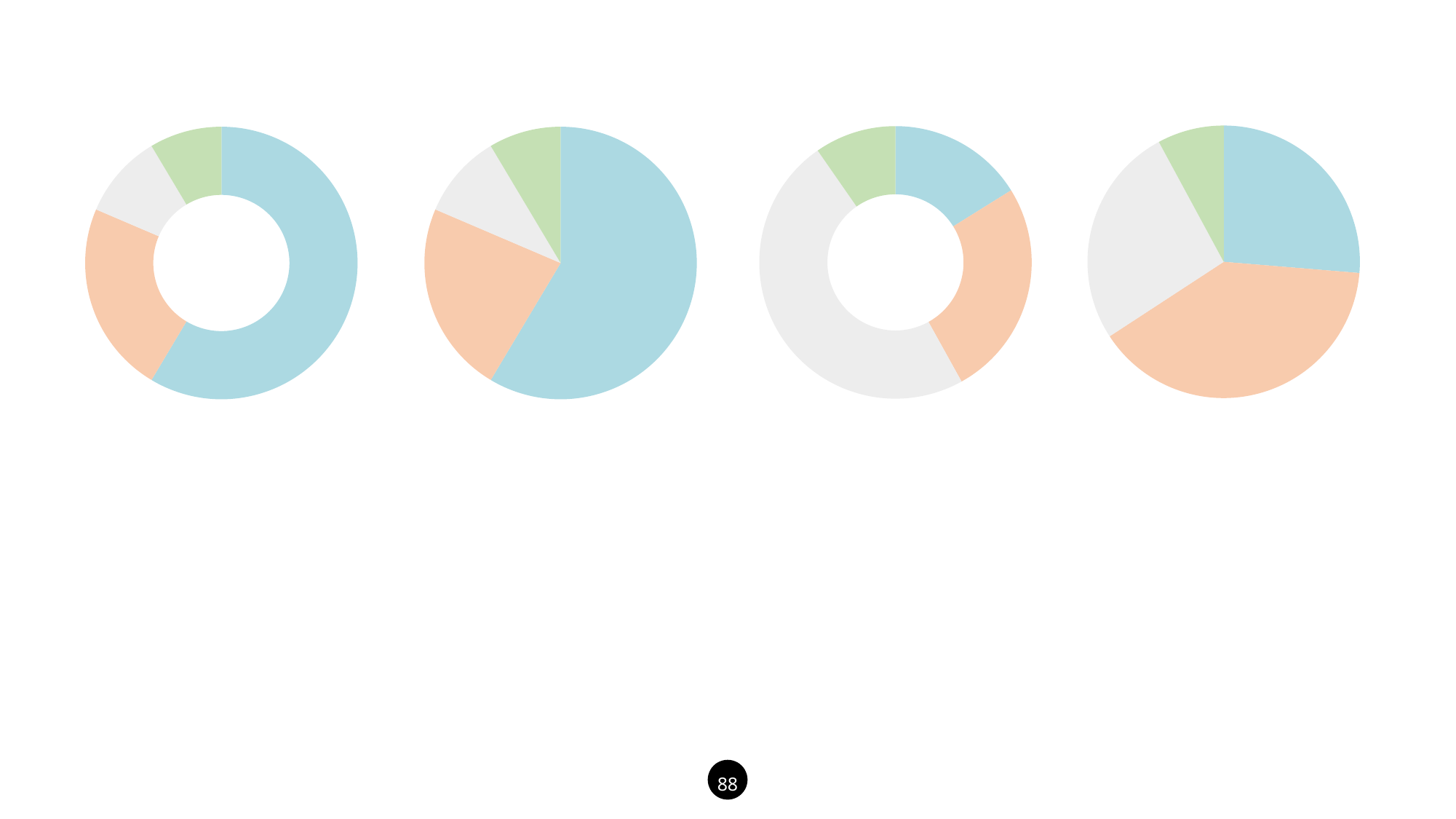
What kind of chart is the leftmost chart on the slide? Doughnut chart In the third chart from the left, which colour slice is the largest? Grey In the leftmost doughnut chart, which colour slice is the largest? Blue In the second chart from the left, which colour slice is the largest? Blue How many charts are shown on the slide? 4 In the rightmost pie chart, which is larger, the orange slice or the blue slice? Orange How many slices does the leftmost doughnut chart have? 4 What kind of chart is the rightmost chart on the slide? Pie chart In the third chart from the left, which colour slice is the smallest? Green How many slices does the rightmost pie chart have? 4 What kind of chart is the second chart from the left? Pie chart